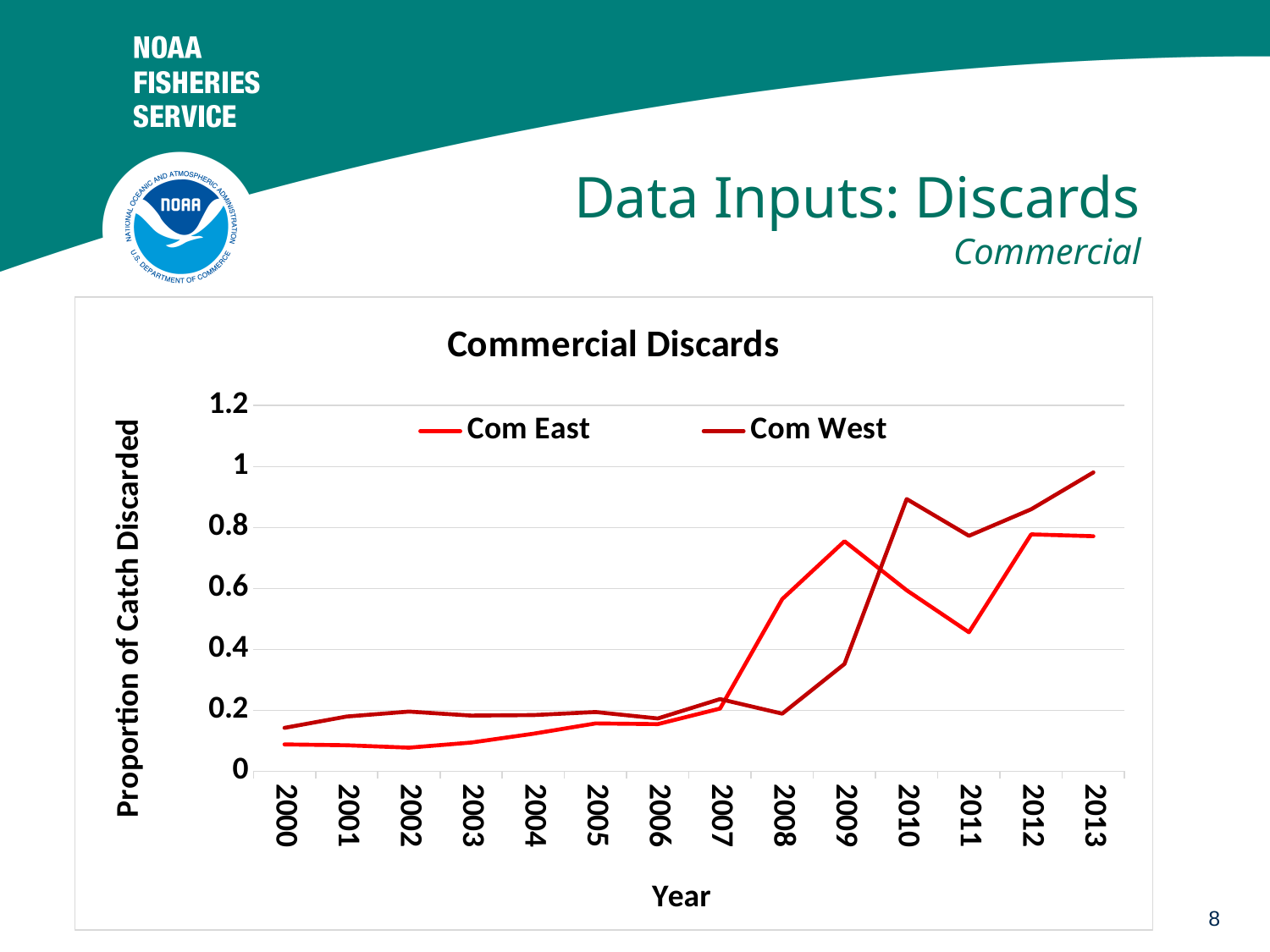
What kind of chart is shown on the slide? Line chart Is the value for Com East in 2008 greater or less than 0.4? greater Is the value for Com East in 2011 greater or less than 0.6? less In 2010, which series has the larger value, Com East or Com West? Com West What are the two series named in the legend of the Commercial Discards chart? Com East and Com West How many years are plotted along the x axis of the Commercial Discards chart? 14 Is the value for Com West in 2013 greater or less than 0.8? greater In 2009, which series has the larger value, Com East or Com West? Com East What is the title of the y axis on the Commercial Discards chart? Proportion of Catch Discarded In which year does Com West reach its highest value? 2013 Does the Com West line rise or fall between 2009 and 2010? Rise How many series does the legend of the Commercial Discards chart list? 2